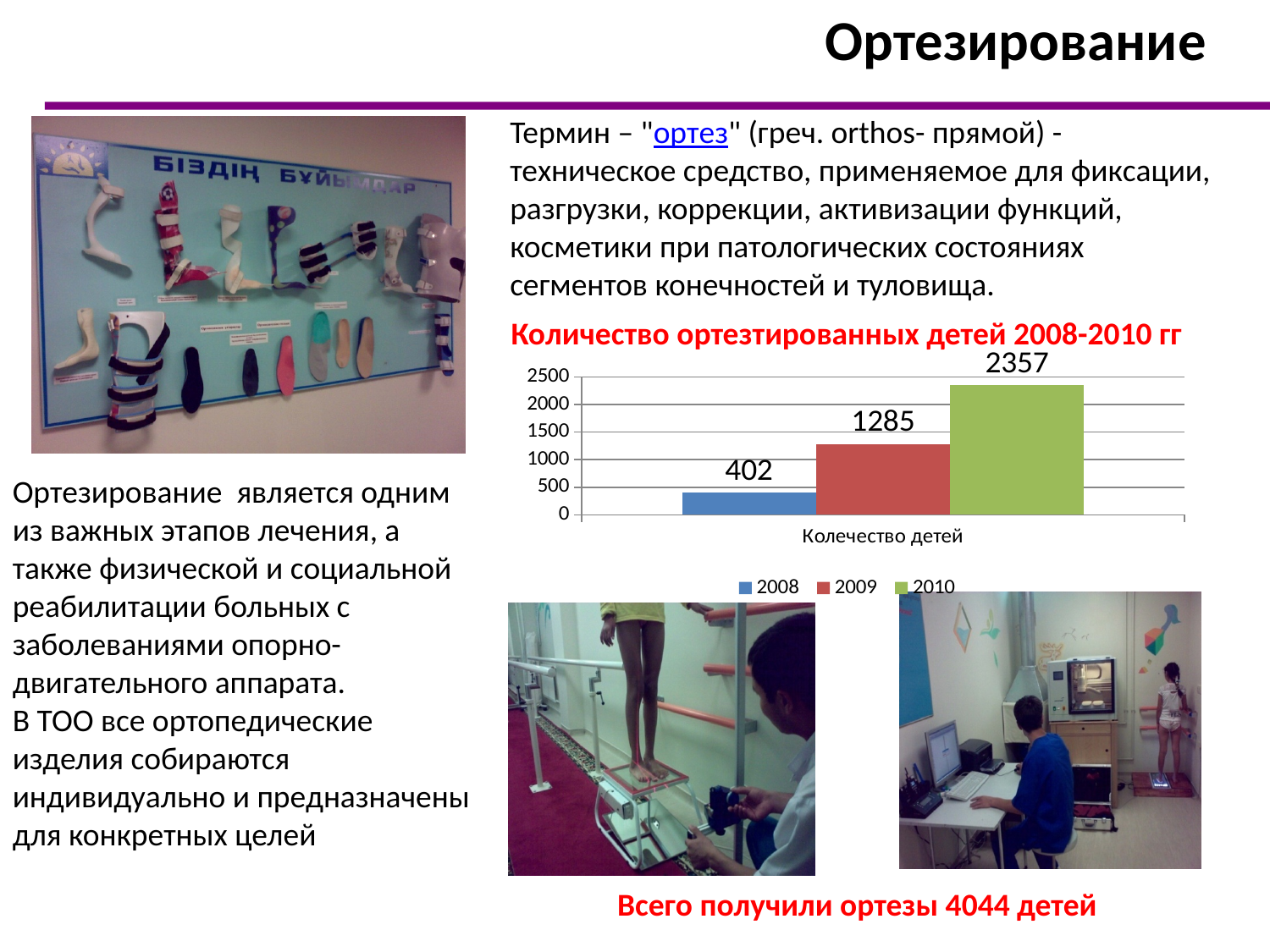
What is the value for 2009 in the chart? 1285 What is the value for 2010 in the chart? 2357 Which year has the lowest value in the chart? 2008 Which year has the highest value in the chart? 2010 Do the values rise or fall from 2008 to 2010? Rise How many series does the legend list? 3 What is the value for 2008 in the chart? 402 Which is larger, the value for 2009 or the value for 2008? 2009 What is the difference between the values for 2009 and 2008? 883 What is the title of the chart? Количество ортезированных детей 2008-2010 гг What kind of chart is shown on the slide? Bar chart What is the difference between the values for 2010 and 2009? 1072